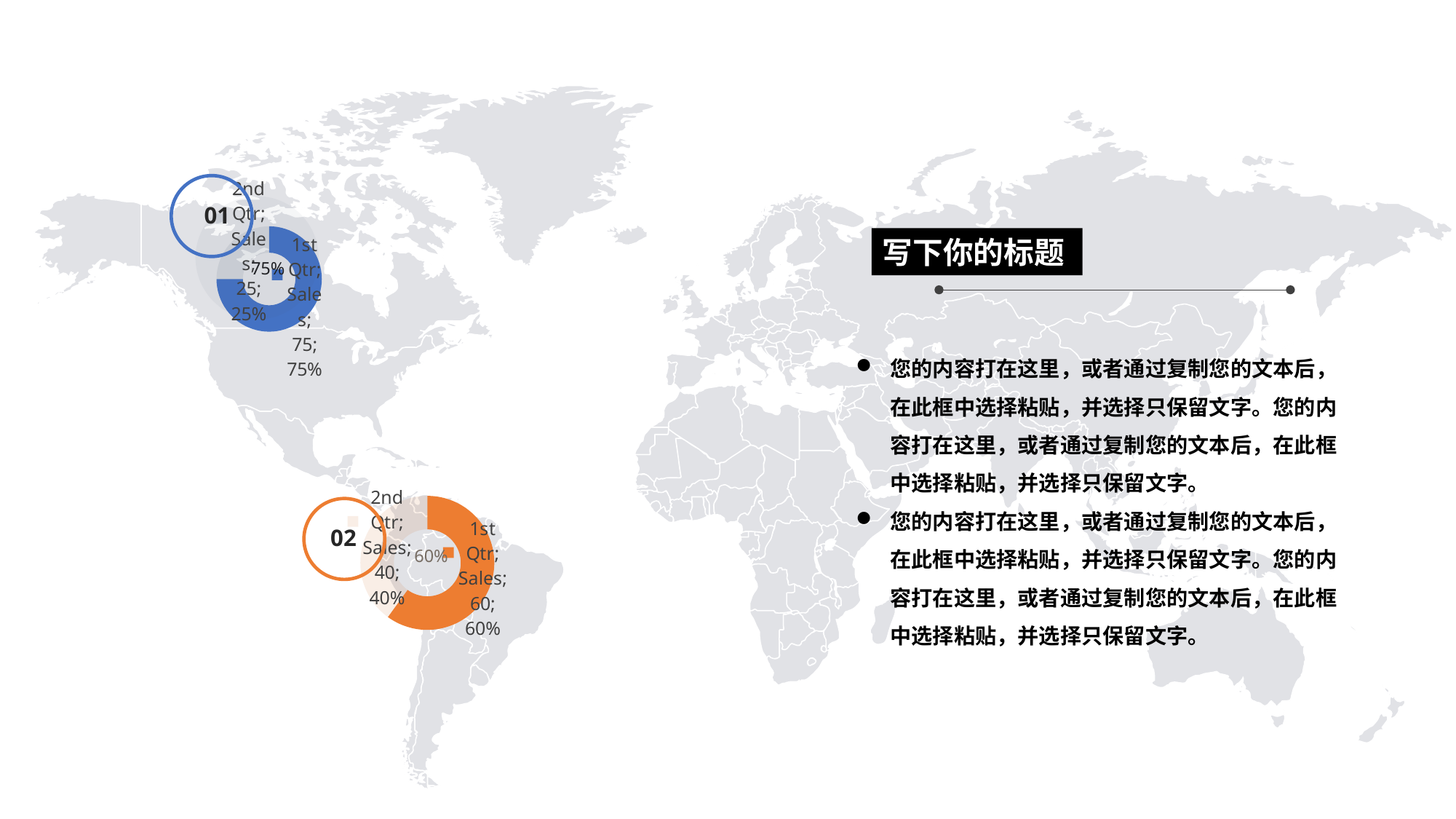
In the blue doughnut chart labelled 01, what is the difference between the 1st Qtr Sales and 2nd Qtr Sales values? 50 How many categories are shown in the blue doughnut chart labelled 01? 2 In the blue doughnut chart labelled 01, what percentage share does 2nd Qtr Sales have? 25% In the orange doughnut chart labelled 02, what is the value for 1st Qtr Sales? 60 In the orange doughnut chart labelled 02, which is larger: 1st Qtr Sales or 2nd Qtr Sales? 1st Qtr Sales What percentage is printed in the centre of the orange doughnut chart labelled 02? 60% In the orange doughnut chart labelled 02, which category has the smallest share? 2nd Qtr Sales What type of chart is the orange chart labelled 02? Doughnut chart In the blue doughnut chart labelled 01, what is the value for 1st Qtr Sales? 75 In the orange doughnut chart labelled 02, what percentage share does 2nd Qtr Sales have? 40% In the blue doughnut chart labelled 01, which category has the largest share? 1st Qtr Sales In the orange doughnut chart labelled 02, what is the difference between the 1st Qtr Sales and 2nd Qtr Sales values? 20